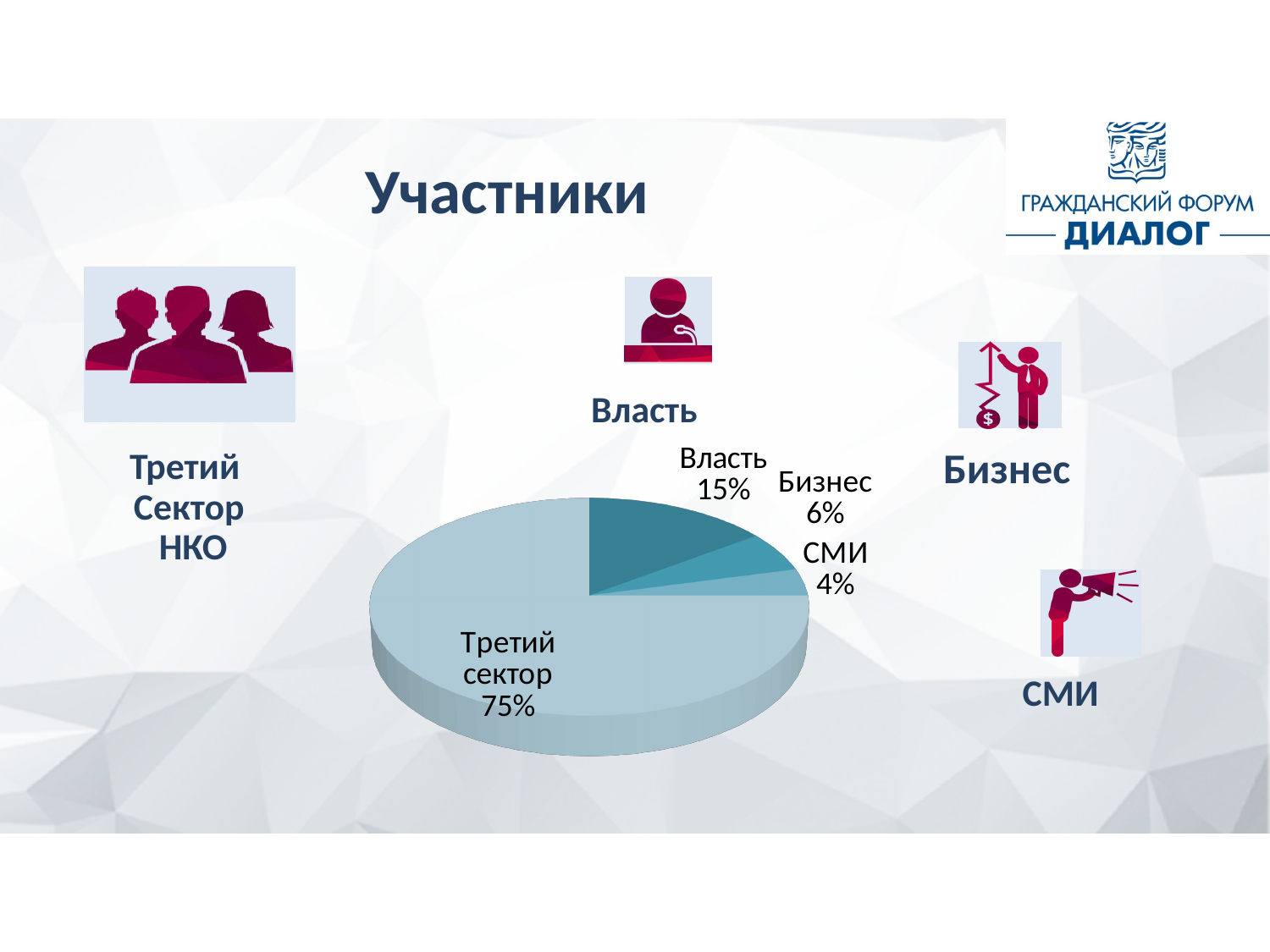
What is the difference between the shares of Власть and Бизнес? 9% Which category has the smallest slice in the pie chart? СМИ Which category has the largest slice in the pie chart? Третий сектор What is the value shown for Власть in the pie chart? 15% What is the value shown for Бизнес in the pie chart? 6% What share of the pie chart does Третий сектор hold? 75% How many categories are shown in the pie chart? 4 What is the difference between the shares of Третий сектор and Власть? 60% What is the value shown for СМИ in the pie chart? 4% Which is larger, the share for Бизнес or the share for СМИ? Бизнес What is the title of the slide containing the chart? Участники What kind of chart is shown on the slide? Pie chart